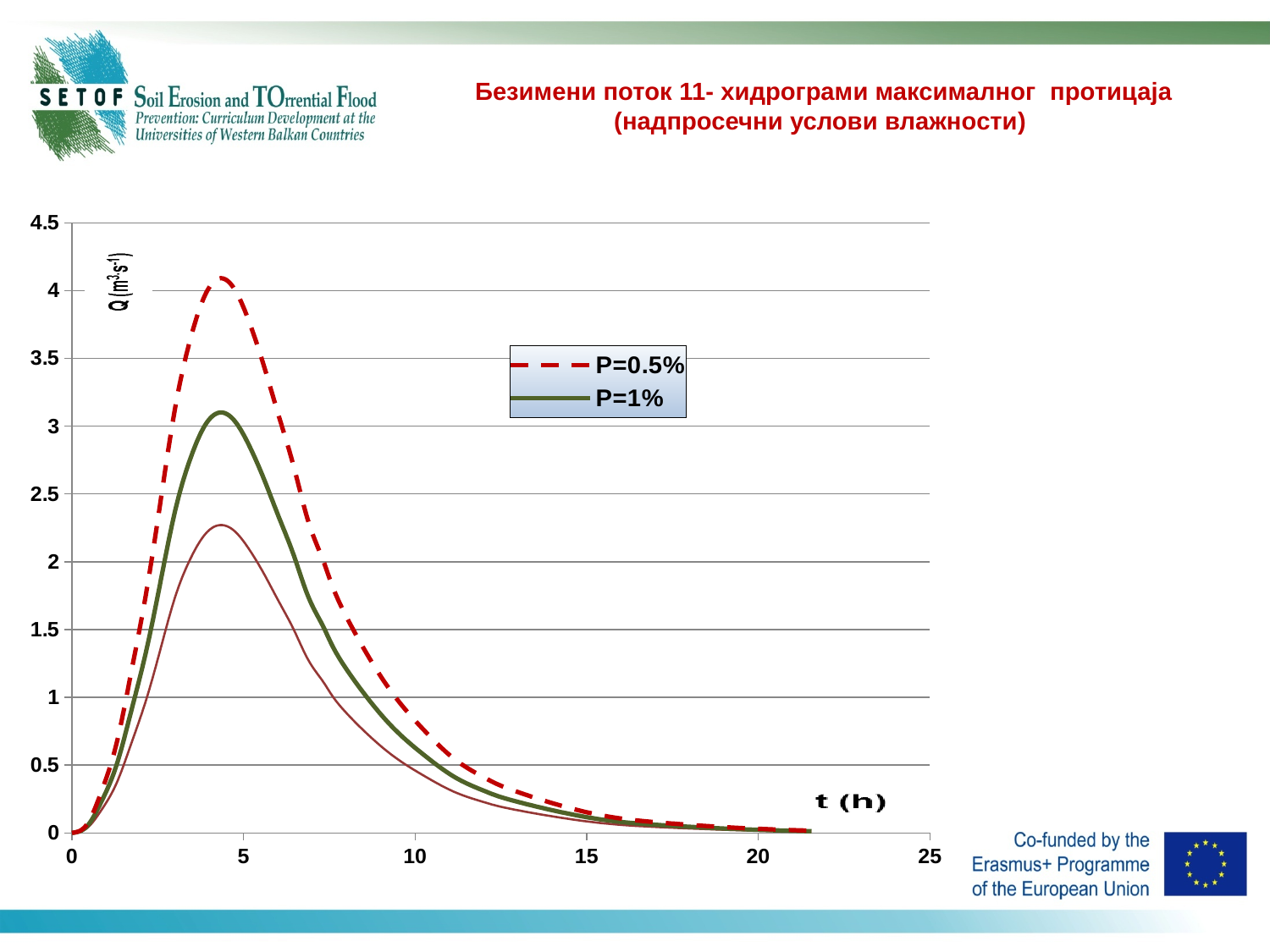
Is the peak value of the P=1% series greater or less than 3.5? less Is the value of the P=0.5% series at t = 15 h greater or less than 0.5? less Is the peak value of the P=0.5% series greater or less than 3.5? greater What kind of chart is shown on the slide? line chart Which series is drawn with a dashed red line? P=0.5% Which series reaches the higher peak discharge, P=0.5% or P=1%? P=0.5% After reaching their peaks, do the curves rise or fall as t increases? fall What is the label of the x axis? t (h) How many series does the legend list? 2